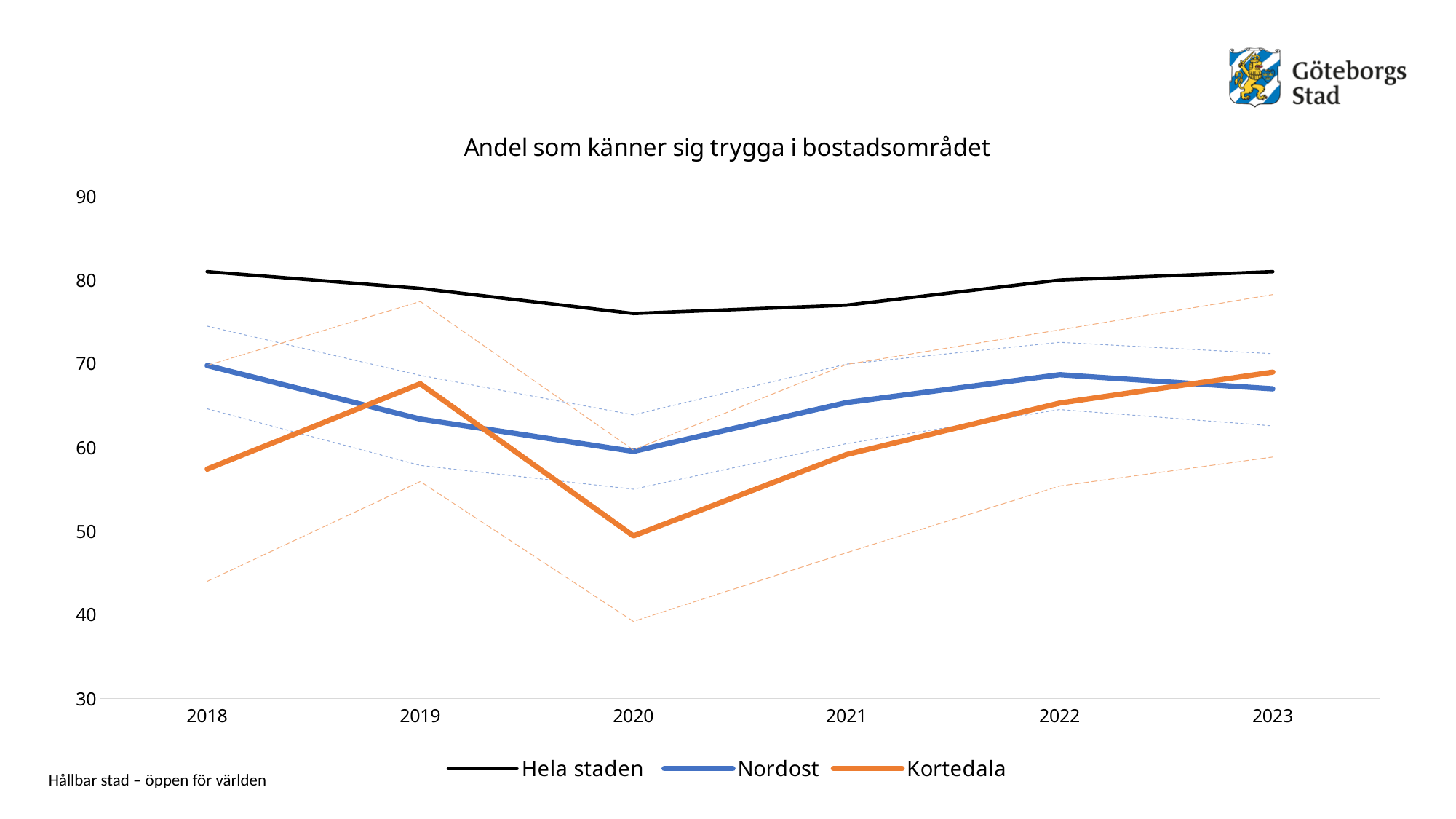
In which year is the value for Kortedala lowest? 2020 How many series does the legend list? 3 In which year is the value for Hela staden lowest? 2020 What kind of chart is shown on the slide? line chart What is the title of the chart? Andel som känner sig trygga i bostadsområdet Does the value for Kortedala rise or fall from 2020 to 2023? rise Is the value for Kortedala in 2018 greater or less than 60? less In which year is the value for Nordost lowest? 2020 Which series is drawn in orange? Kortedala In 2020, which is larger: Hela staden or Kortedala? Hela staden How many years are shown on the x axis? 6 In 2019, which is larger: Nordost or Kortedala? Kortedala